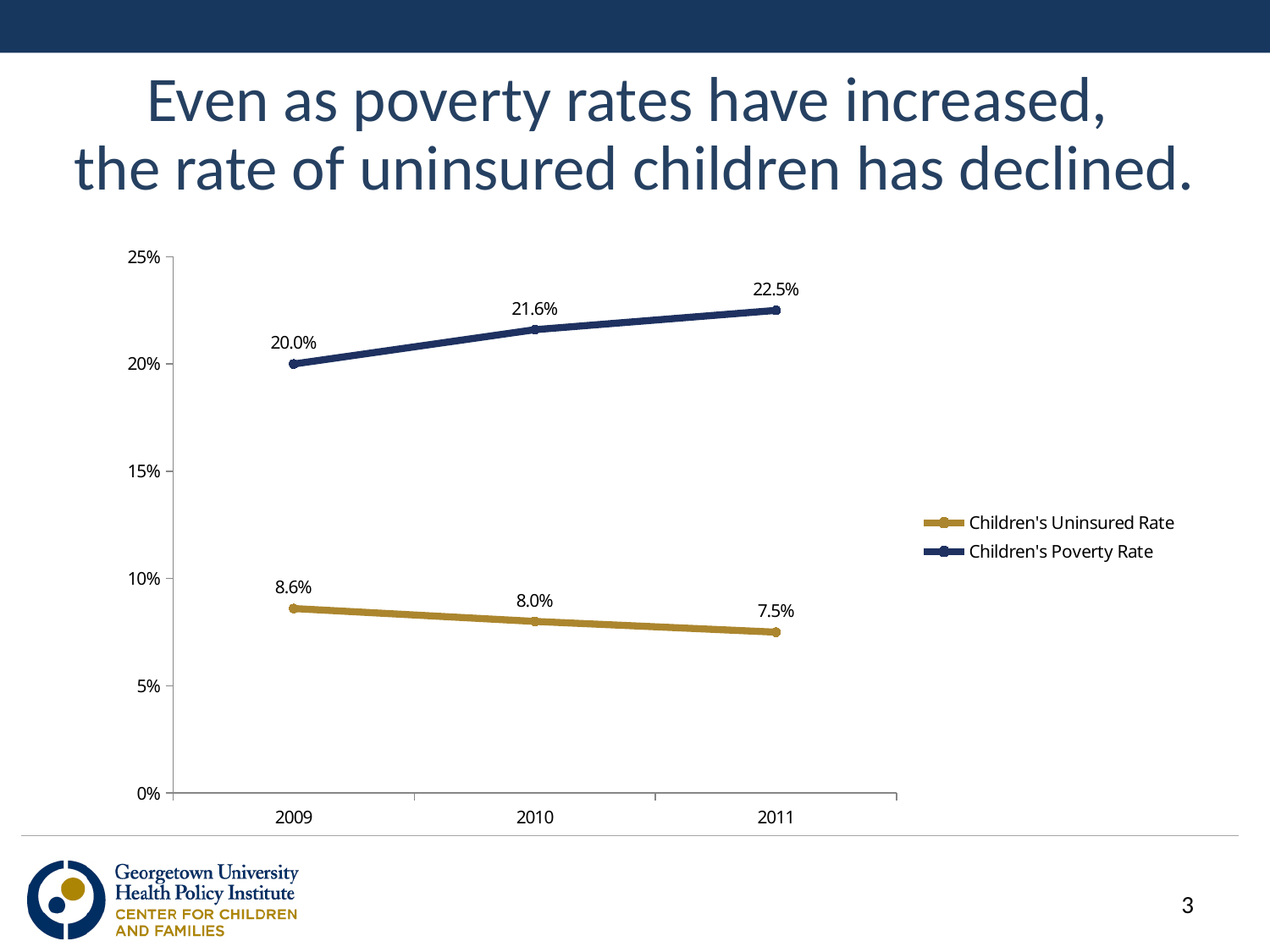
What was the Children's Poverty Rate in 2010? 21.6% How many years are shown on the x axis? 3 Does the Children's Uninsured Rate rise or fall from 2009 to 2011? Fall What was the Children's Uninsured Rate in 2011? 7.5% What was the Children's Uninsured Rate in 2009? 8.6% In which year was the Children's Poverty Rate highest? 2011 How many series does the legend list? 2 In which year was the Children's Uninsured Rate lowest? 2011 By how many percentage points did the Children's Poverty Rate change from 2009 to 2011? 2.5 percentage points What kind of chart is shown on the slide? Line chart What is the difference between the Children's Poverty Rate and the Children's Uninsured Rate in 2010? 13.6 percentage points Which was larger in 2009, the Children's Uninsured Rate or the Children's Poverty Rate? Children's Poverty Rate